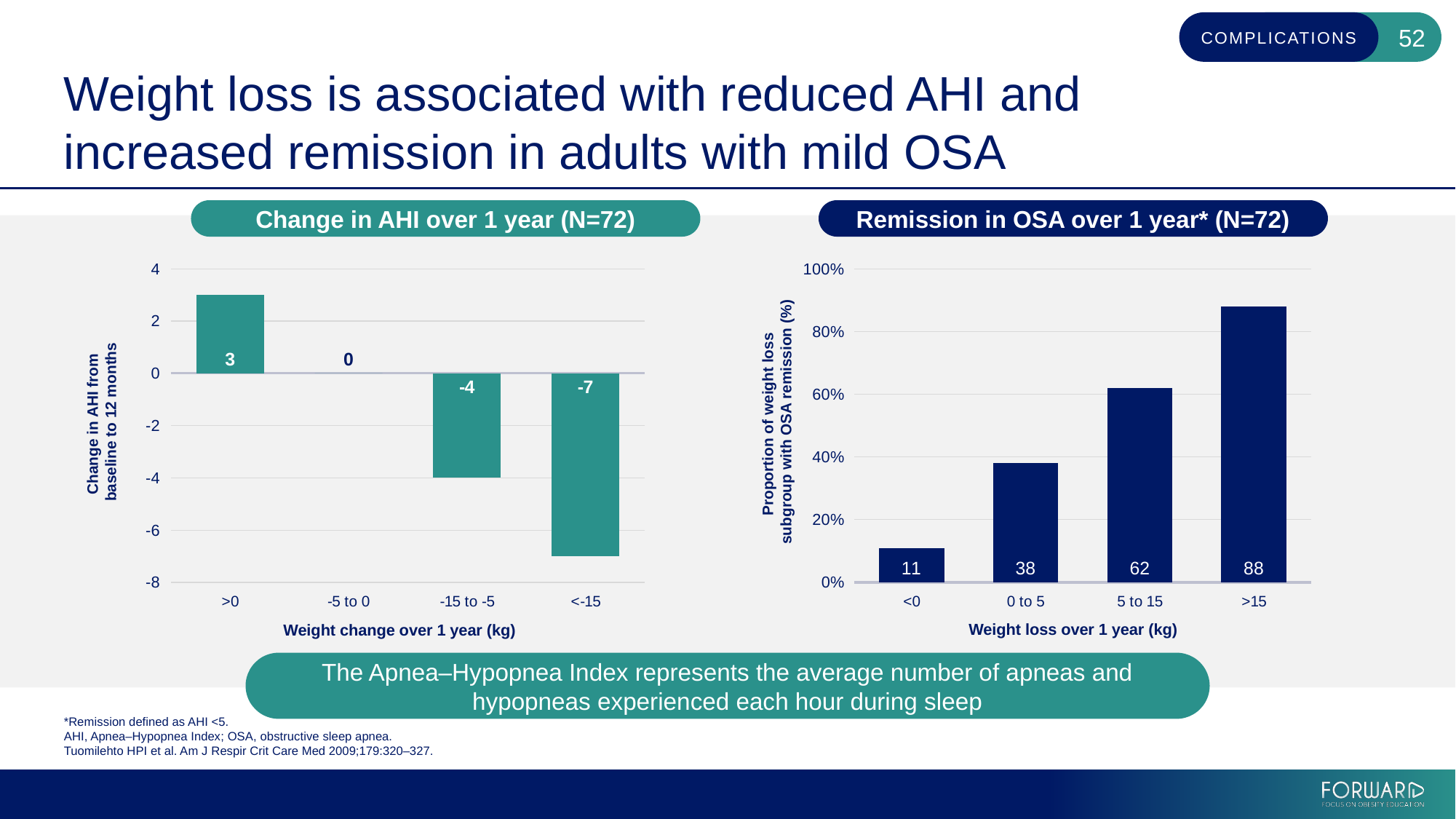
In the 'Remission in OSA over 1 year* (N=72)' chart, is the value for '0 to 5' larger or smaller than the value for '5 to 15'? smaller What kind of chart is the 'Remission in OSA over 1 year* (N=72)' chart? bar chart In the 'Change in AHI over 1 year (N=72)' chart, which weight change group has the lowest change in AHI? <-15 In the 'Remission in OSA over 1 year* (N=72)' chart, what is the difference between the values for '>15' and '0 to 5'? 50 In the 'Change in AHI over 1 year (N=72)' chart, what is the difference between the values for '>0' and '-15 to -5'? 7 In the 'Remission in OSA over 1 year* (N=72)' chart, which weight loss group has the lowest proportion with OSA remission? <0 In the 'Remission in OSA over 1 year* (N=72)' chart, what is the value for the '5 to 15' weight loss group? 62 In the 'Remission in OSA over 1 year* (N=72)' chart, which weight loss group has the highest proportion with OSA remission? >15 In the 'Change in AHI over 1 year (N=72)' chart, how many weight change categories are shown? 4 In the 'Change in AHI over 1 year (N=72)' chart, what is the change in AHI for the '<-15' weight change group? -7 In the 'Change in AHI over 1 year (N=72)' chart, what is the change in AHI for the '>0' weight change group? 3 In the 'Change in AHI over 1 year (N=72)' chart, do the values rise or fall from left to right along the x axis? fall